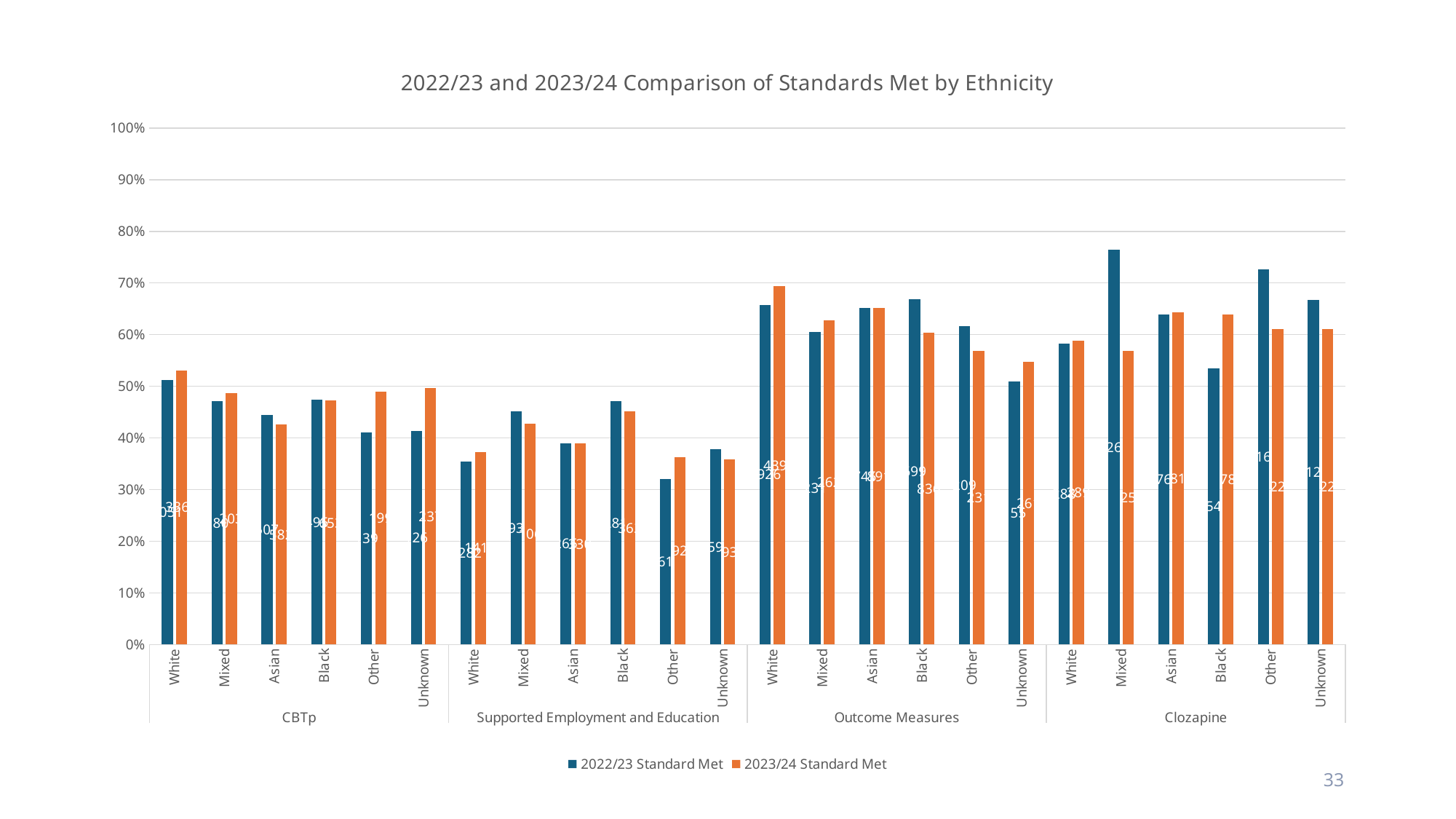
For Black under Clozapine, which series has the larger value, 2022/23 Standard Met or 2023/24 Standard Met? 2023/24 Standard Met Is the 2022/23 Standard Met value for Mixed under Clozapine greater or less than 70%? greater How many standard groups (e.g. CBTp, Clozapine) are shown along the x axis? 4 Within the Clozapine group, which ethnicity has the highest 2022/23 Standard Met value? Mixed What kind of chart is shown on the slide? Bar chart Is the 2023/24 Standard Met value for White under Outcome Measures greater or less than 60%? greater What are the two series named in the legend? 2022/23 Standard Met and 2023/24 Standard Met Is the 2022/23 Standard Met value for Other under Supported Employment and Education greater or less than 40%? less How many series does the legend list? 2 How many ethnicity categories are shown within each standard group? 6 For Mixed under Clozapine, which series has the larger value, 2022/23 Standard Met or 2023/24 Standard Met? 2022/23 Standard Met Within the Supported Employment and Education group, which ethnicity has the lowest 2022/23 Standard Met value? Other